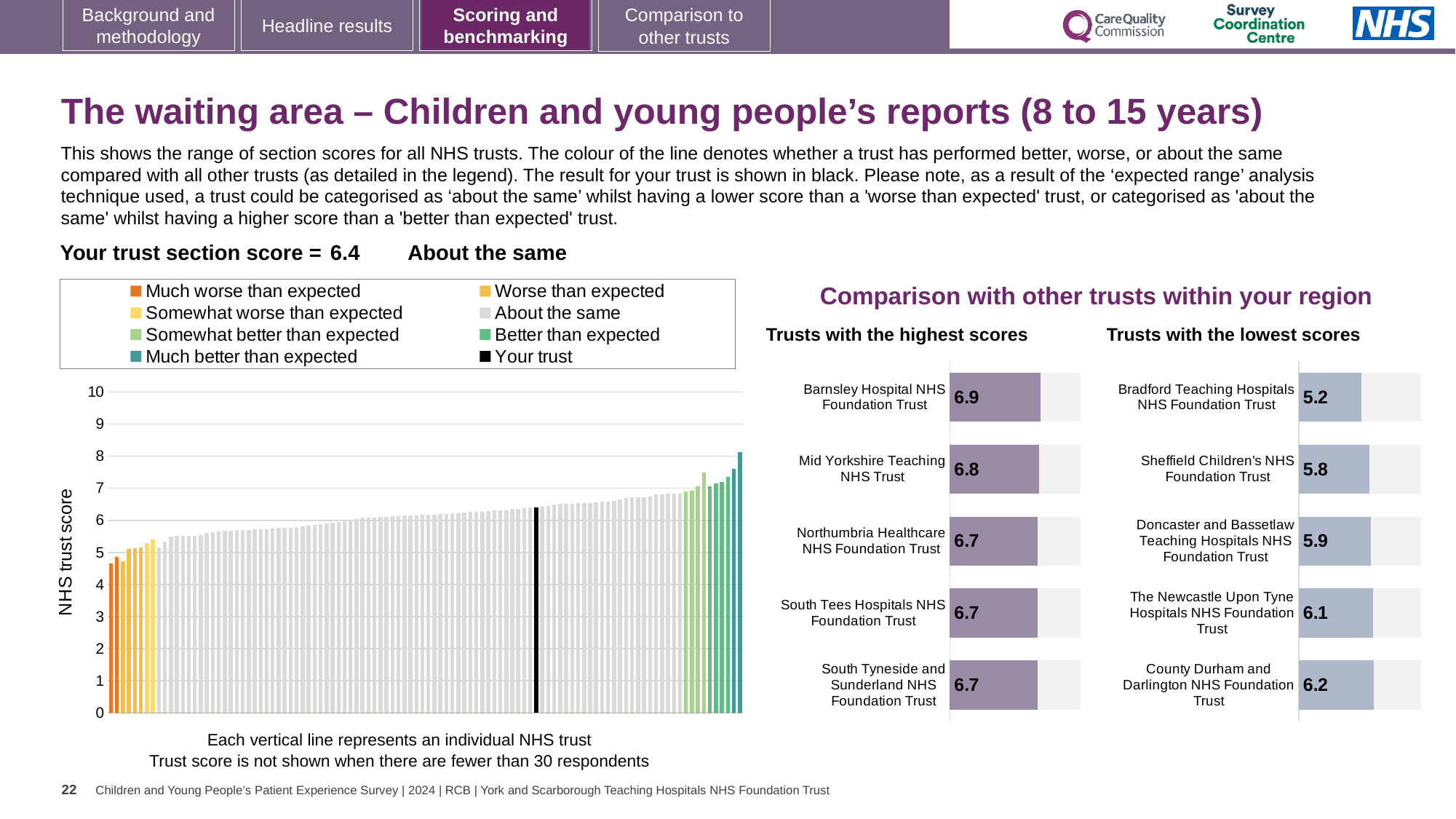
In the 'Trusts with the highest scores' chart, what is the score for Mid Yorkshire Teaching NHS Trust? 6.8 In the large chart on the left, do the trust scores rise or fall from left to right? rise In the 'Trusts with the lowest scores' chart, which trust has the lowest score? Bradford Teaching Hospitals NHS Foundation Trust In the large chart on the left, is the value of the lowest (leftmost) bar greater or less than 5? less What kind of chart is the large chart on the left showing NHS trust scores? bar chart In the 'Trusts with the lowest scores' chart, which has the higher score: Sheffield Children's NHS Foundation Trust or Doncaster and Bassetlaw Teaching Hospitals NHS Foundation Trust? Doncaster and Bassetlaw Teaching Hospitals NHS Foundation Trust In the 'Trusts with the highest scores' chart, what is the difference between the scores of Barnsley Hospital NHS Foundation Trust and Mid Yorkshire Teaching NHS Trust? 0.1 In the 'Trusts with the highest scores' chart, how many trusts are shown? 5 In the 'Trusts with the highest scores' chart, which trust has the highest score? Barnsley Hospital NHS Foundation Trust How many entries does the legend of the large chart on the left list? 8 In the large chart on the left, what is the section score for your trust (the black bar)? 6.4 In the 'Trusts with the lowest scores' chart, what is the score for The Newcastle Upon Tyne Hospitals NHS Foundation Trust? 6.1